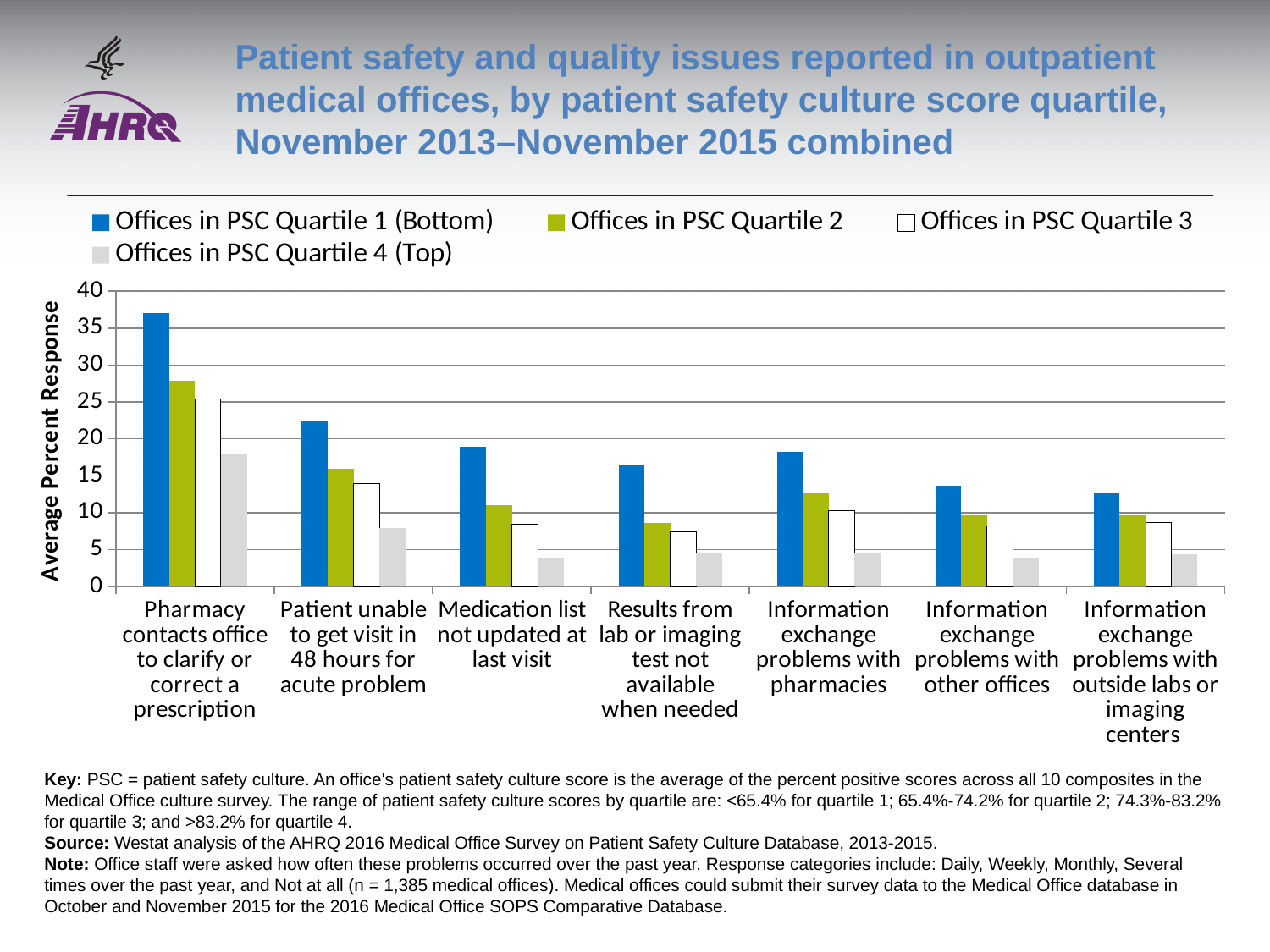
For which issue is the value for Offices in PSC Quartile 1 (Bottom) the highest? Pharmacy contacts office to clarify or correct a prescription What is the title of the y axis? Average Percent Response For 'Pharmacy contacts office to clarify or correct a prescription', which series has the lowest value? Offices in PSC Quartile 4 (Top) How many series does the legend list? 4 Is the value for Offices in PSC Quartile 4 (Top) for 'Medication list not updated at last visit' greater or less than 5? less What kind of chart is shown on the slide? Bar chart Is the value for Offices in PSC Quartile 1 (Bottom) for 'Pharmacy contacts office to clarify or correct a prescription' greater or less than 35? greater Which series is shown in grey in the legend? Offices in PSC Quartile 4 (Top) For 'Medication list not updated at last visit', which is larger: the value for Offices in PSC Quartile 1 (Bottom) or Offices in PSC Quartile 4 (Top)? Offices in PSC Quartile 1 (Bottom) How many issue categories are shown along the x axis? 7 Is the value for Offices in PSC Quartile 1 (Bottom) for 'Patient unable to get visit in 48 hours for acute problem' greater or less than 20? greater